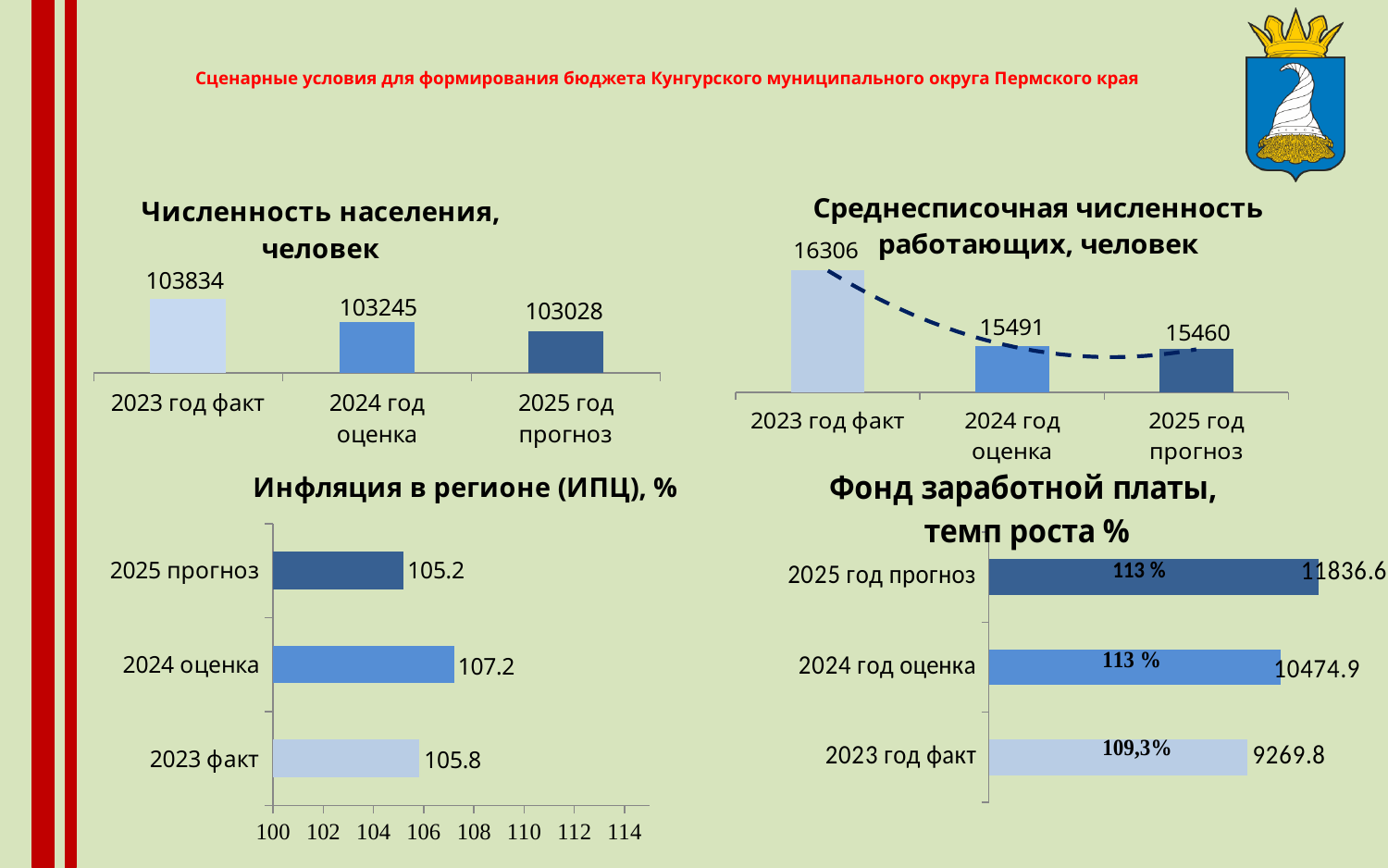
In the chart 'Инфляция в регионе (ИПЦ), %', which category has the lowest value? 2025 прогноз In the chart 'Инфляция в регионе (ИПЦ), %', what is the value for '2024 оценка'? 107.2 What kind of chart is 'Инфляция в регионе (ИПЦ), %'? bar chart In the chart 'Фонд заработной платы, темп роста %', which is larger: the value for '2025 год прогноз' or '2024 год оценка'? 2025 год прогноз In the chart 'Фонд заработной платы, темп роста %', what is the value for '2023 год факт'? 9269.8 In the chart 'Численность населения, человек', do the values rise or fall from 2023 to 2025? fall In the chart 'Численность населения, человек', what is the value for '2023 год факт'? 103834 In the chart 'Среднесписочная численность работающих, человек', what is the value for '2024 год оценка'? 15491 How many charts are shown on the slide? 4 In the chart 'Среднесписочная численность работающих, человек', which category has the highest value? 2023 год факт In the chart 'Среднесписочная численность работающих, человек', what is the difference between the values for '2023 год факт' and '2024 год оценка'? 815 In the chart 'Численность населения, человек', what is the difference between the values for '2023 год факт' and '2025 год прогноз'? 806